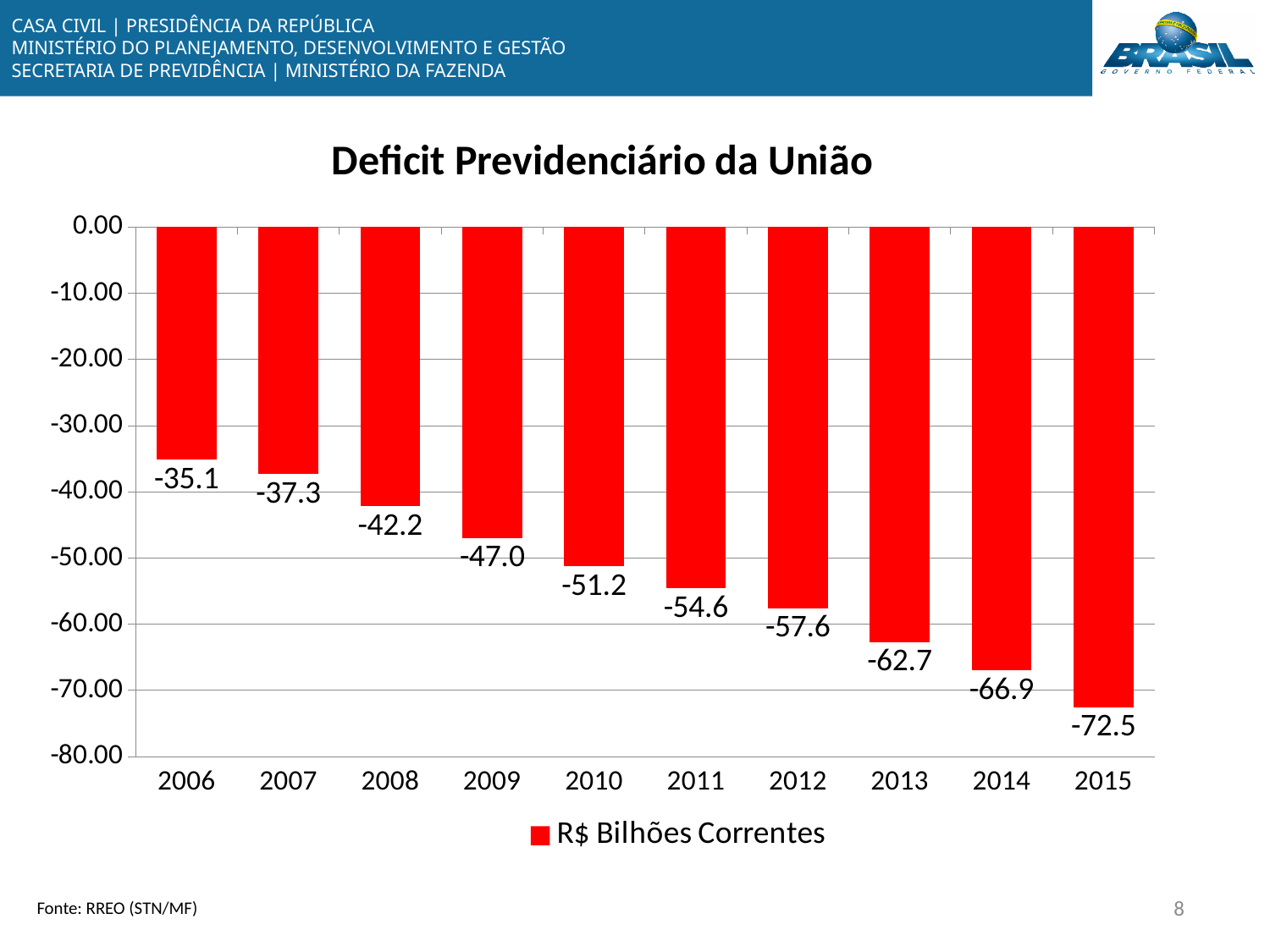
What is the difference between the values for 2015 and 2006? 37.4 What is the value for 2011? -54.6 What is the value for 2006? -35.1 What is the value for 2015? -72.5 How many series does the legend list? 1 Which year has the lowest (most negative) value? 2015 What kind of chart is shown? bar chart Which year has the highest (least negative) value? 2006 How many years are shown on the x axis? 10 Which is more negative, the value for 2012 or the value for 2013? 2013 Do the values rise or fall from 2006 to 2015? fall What is the difference between the values for 2010 and 2009? 4.2